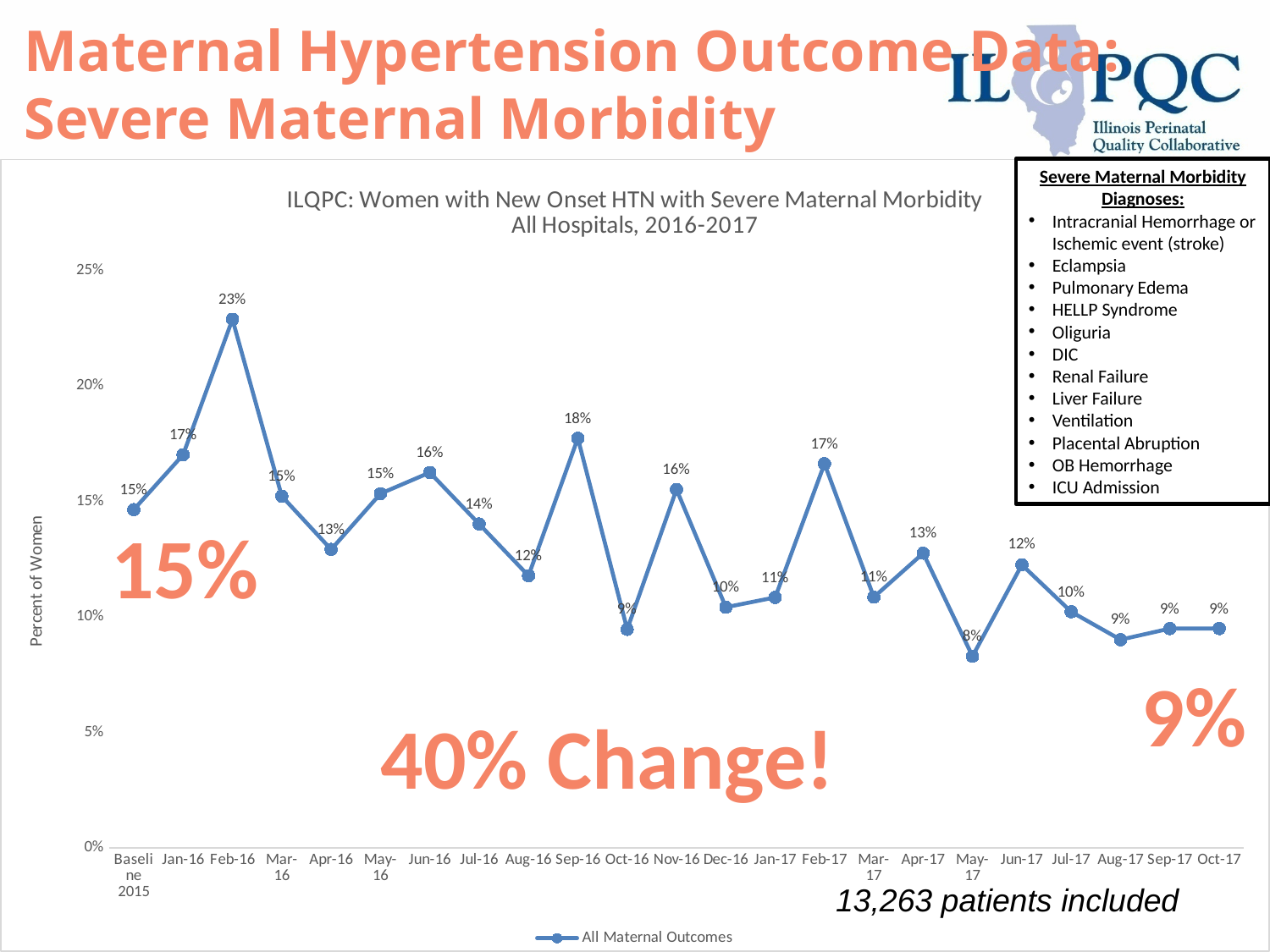
What is the value for Feb-16? 23% Which month has the highest value? Feb-16 What is the value for Sep-16? 18% Which is larger, the value for Nov-16 or the value for Dec-16? Nov-16 What is the value for Oct-17? 9% How many series does the legend list? 1 What type of chart is shown on the slide? line chart How many data points are plotted on the line? 23 Which month has the lowest value? May-17 What is the difference between the Feb-16 value and the May-17 value? 15% What is the label of the y axis? Percent of Women What is the value for May-17? 8%